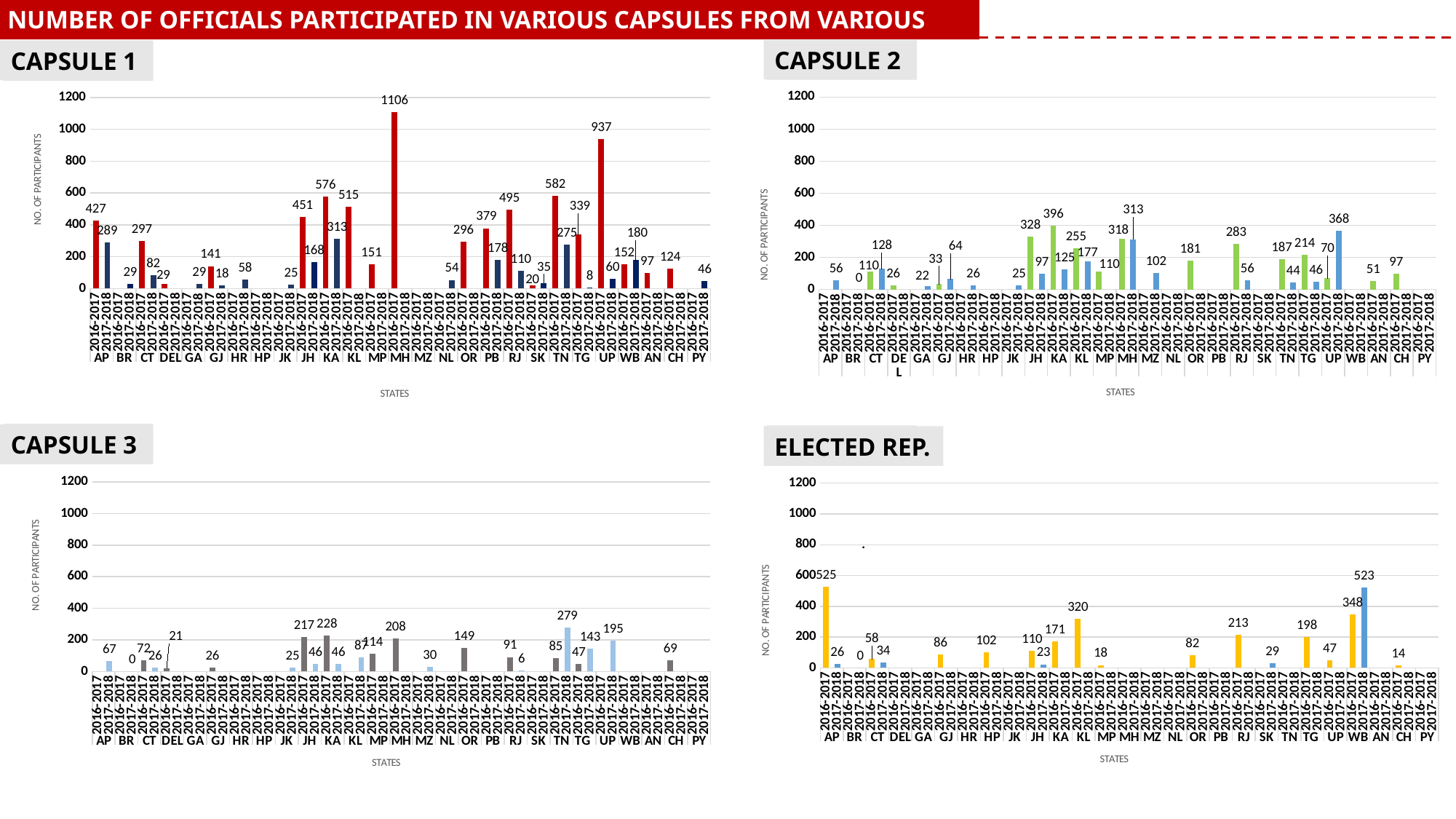
In the CAPSULE 1 chart, is the value for UP in 2016-2017 greater or less than 800? greater In the CAPSULE 2 chart, how many participants are shown for KA in 2016-2017? 396 What type of chart is the CAPSULE 2 chart? Bar chart In the ELECTED REP. chart, how many participants are shown for KL in 2016-2017? 320 In the CAPSULE 1 chart, what is the difference between the AP values for 2016-2017 and 2017-2018? 138 What is the y-axis title of the CAPSULE 3 chart? NO. OF PARTICIPANTS In the CAPSULE 3 chart, which state and year has the highest number of participants? TN, 2017-2018 In the CAPSULE 1 chart, how many participants are shown for MH in 2016-2017? 1106 In the CAPSULE 3 chart, how many participants are shown for MH in 2016-2017? 208 In the CAPSULE 2 chart, which is larger: JH 2016-2017 or UP 2017-2018? UP 2017-2018 In the CAPSULE 1 chart, which state and year has the highest number of participants? MH, 2016-2017 In the ELECTED REP. chart, what is the difference between the WB values for 2017-2018 and 2016-2017? 175